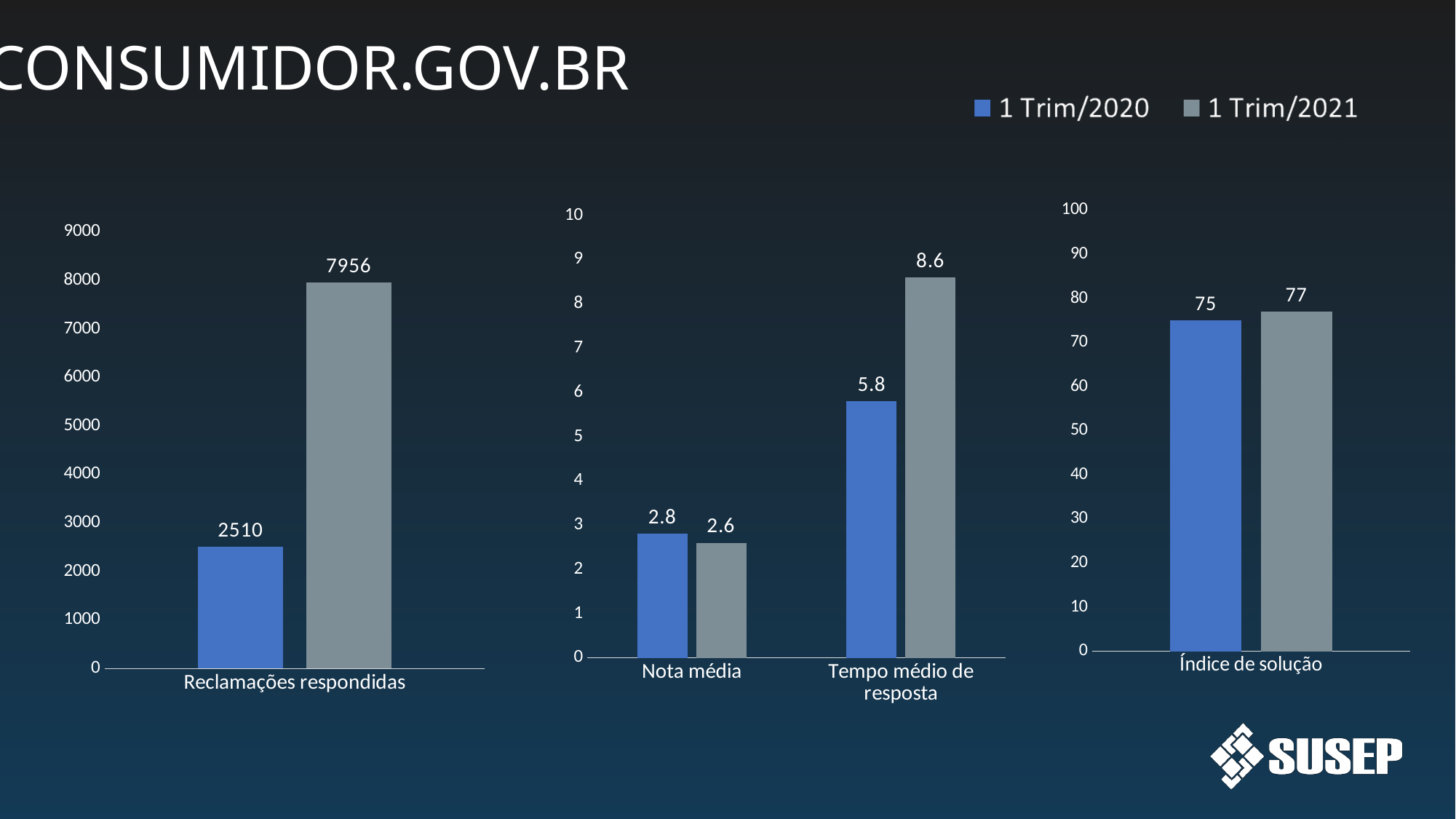
In the middle chart, what is the value for 1 Trim/2021 for Tempo médio de resposta? 8.6 In the left chart, what is the value for 1 Trim/2021 for Reclamações respondidas? 7956 In the middle chart, how many categories are shown on the x axis? 2 In the middle chart, what is the value for 1 Trim/2020 for Nota média? 2.8 In the right chart, what is the difference between the 1 Trim/2021 and 1 Trim/2020 values for Índice de solução? 2 What kind of chart is the left chart? bar chart How many series does the legend list? 2 In the left chart, what is the value for 1 Trim/2020 for Reclamações respondidas? 2510 In the middle chart, what is the difference between the 1 Trim/2021 and 1 Trim/2020 values for Tempo médio de resposta? 2.8 In the middle chart, which series has the larger value for Nota média, 1 Trim/2020 or 1 Trim/2021? 1 Trim/2020 In the left chart, what is the difference between the 1 Trim/2021 and 1 Trim/2020 values for Reclamações respondidas? 5446 In the right chart, what is the value for 1 Trim/2021 for Índice de solução? 77